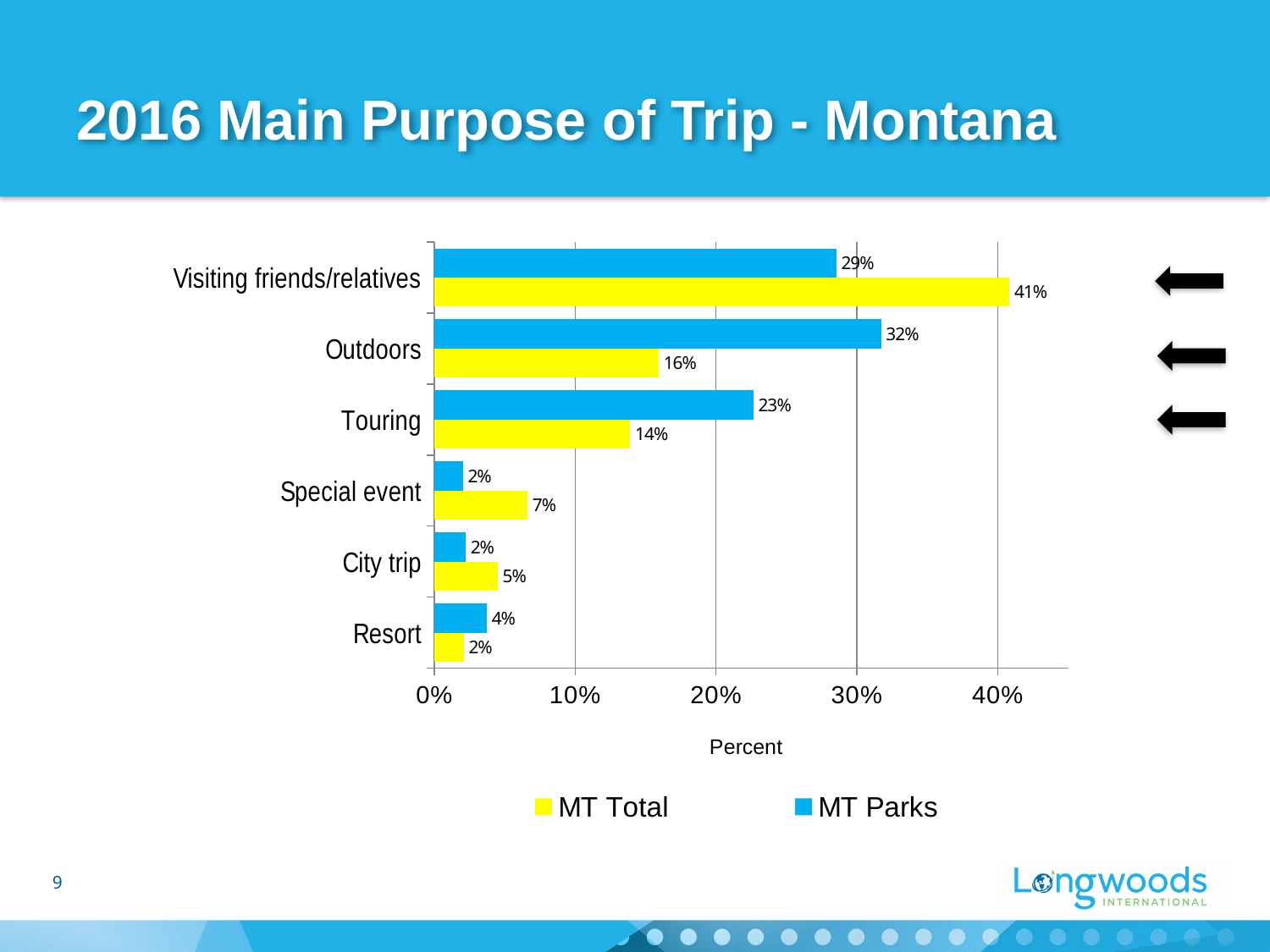
What is the MT Parks value for Touring? 23% What is the difference between the MT Total and MT Parks values for Visiting friends/relatives? 12% How many series does the legend list? 2 Which category has the highest MT Parks value? Outdoors Which colour represents the MT Total series? Yellow How many trip purpose categories are shown on the chart? 6 Which category has the lowest MT Total value? Resort For Outdoors, which series has the larger value, MT Total or MT Parks? MT Parks What is the MT Total value for Visiting friends/relatives? 41% What is the MT Parks value for Outdoors? 32% What is the MT Total value for Special event? 7% What kind of chart is shown on the slide? Bar chart